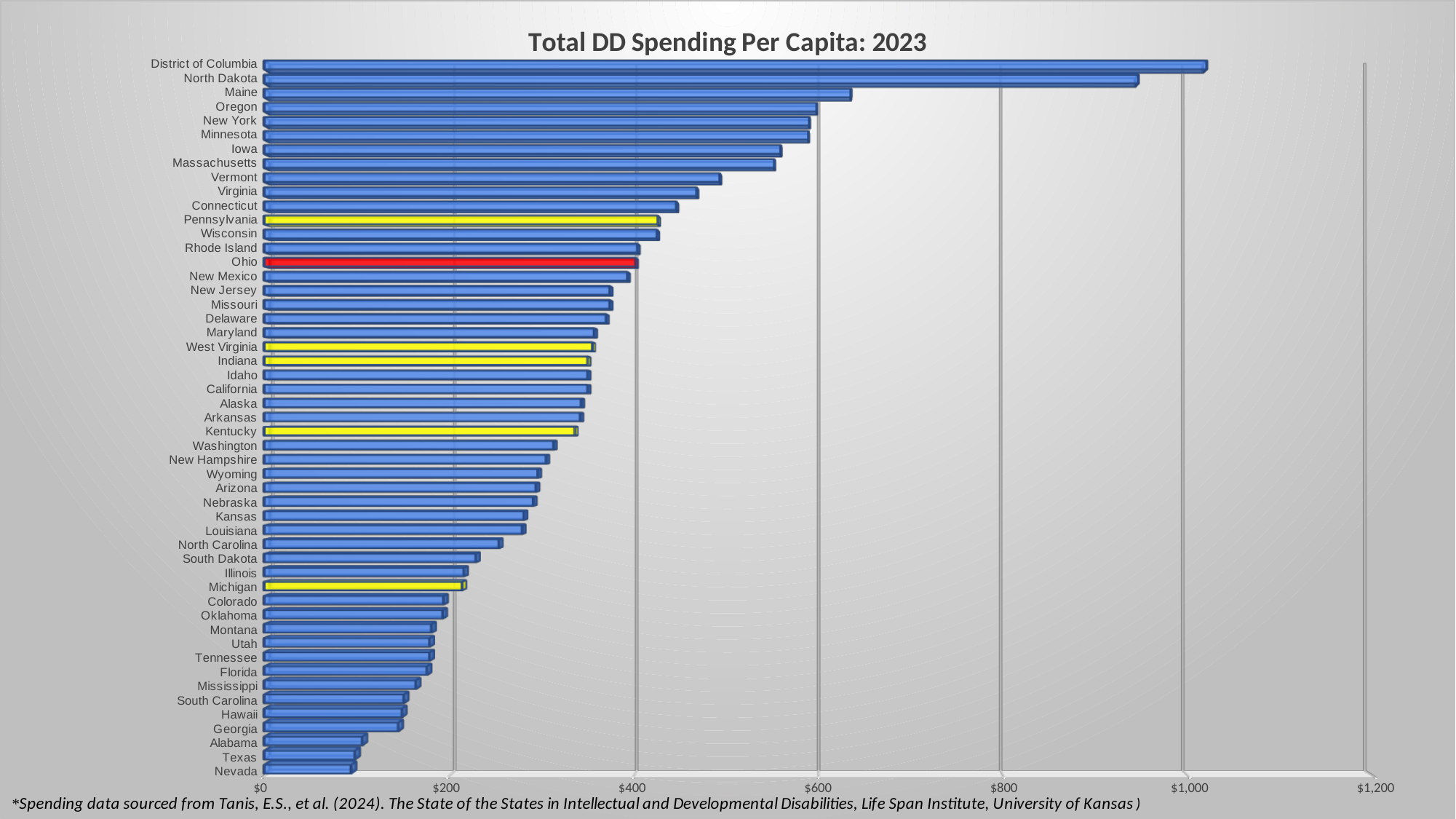
Which category has the highest total DD spending per capita? District of Columbia Is the value for North Dakota greater or less than $1,000? less How many categories (states and districts) are plotted on the chart? 51 Is the value for Maine greater or less than $600? greater What is the title of the chart? Total DD Spending Per Capita: 2023 Is the value for Kentucky greater or less than $400? less What type of chart is shown on the slide? Bar chart Which state's bar is coloured red on the chart? Ohio Which has a higher value, Ohio or Michigan? Ohio Which has a higher value, Maine or Oregon? Maine